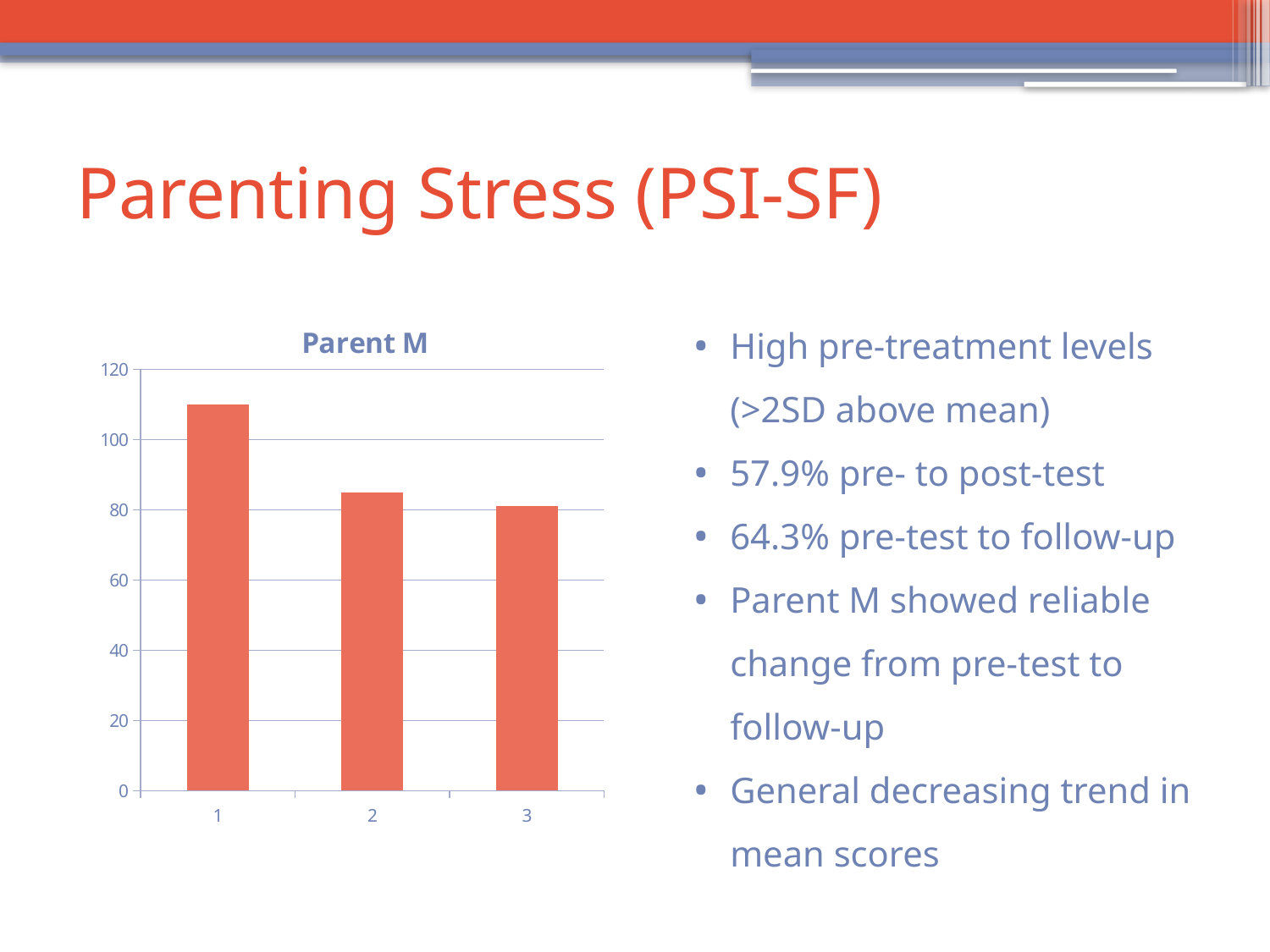
Do the values rise or fall from category 1 to category 3? fall Is the value for category 2 greater or less than 100? less What is the highest value shown on the vertical axis of the chart? 120 Which category has the highest bar in the Parent M chart? 1 Is the value for category 1 greater or less than 100? greater What kind of chart is shown on the slide? bar chart Is the value for category 3 greater or less than 100? less Which is larger, the value for category 1 or the value for category 2? category 1 How many bars are plotted in the Parent M chart? 3 What is the title of the chart? Parent M